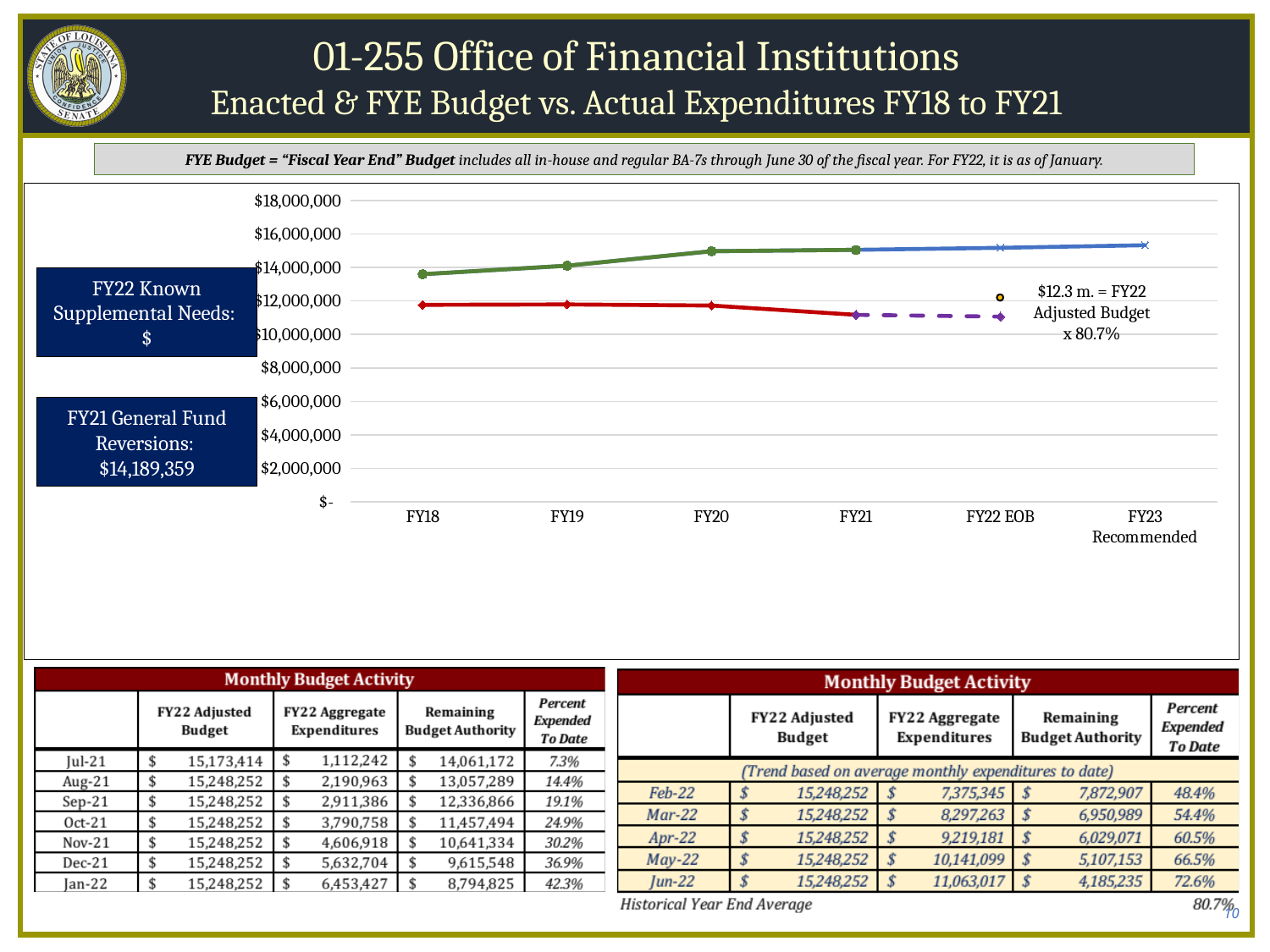
How many fiscal-year categories are shown on the x axis of the chart? 6 Is the value of the green line at FY18 greater or less than $14,000,000? less At FY21, which is higher: the green line or the red line? the green line Is the value of the red line at FY21 greater or less than $12,000,000? less Is the value of the green line at FY18 greater or less than $12,000,000? greater Does the red line rise or fall from FY18 to FY21? fall Does the green line rise or fall from FY18 to FY21? rise What kind of chart is shown on the slide? line chart What is the last category on the x axis of the chart? FY23 Recommended According to the annotation on the chart, what value equals the FY22 Adjusted Budget x 80.7%? $12.3 m.